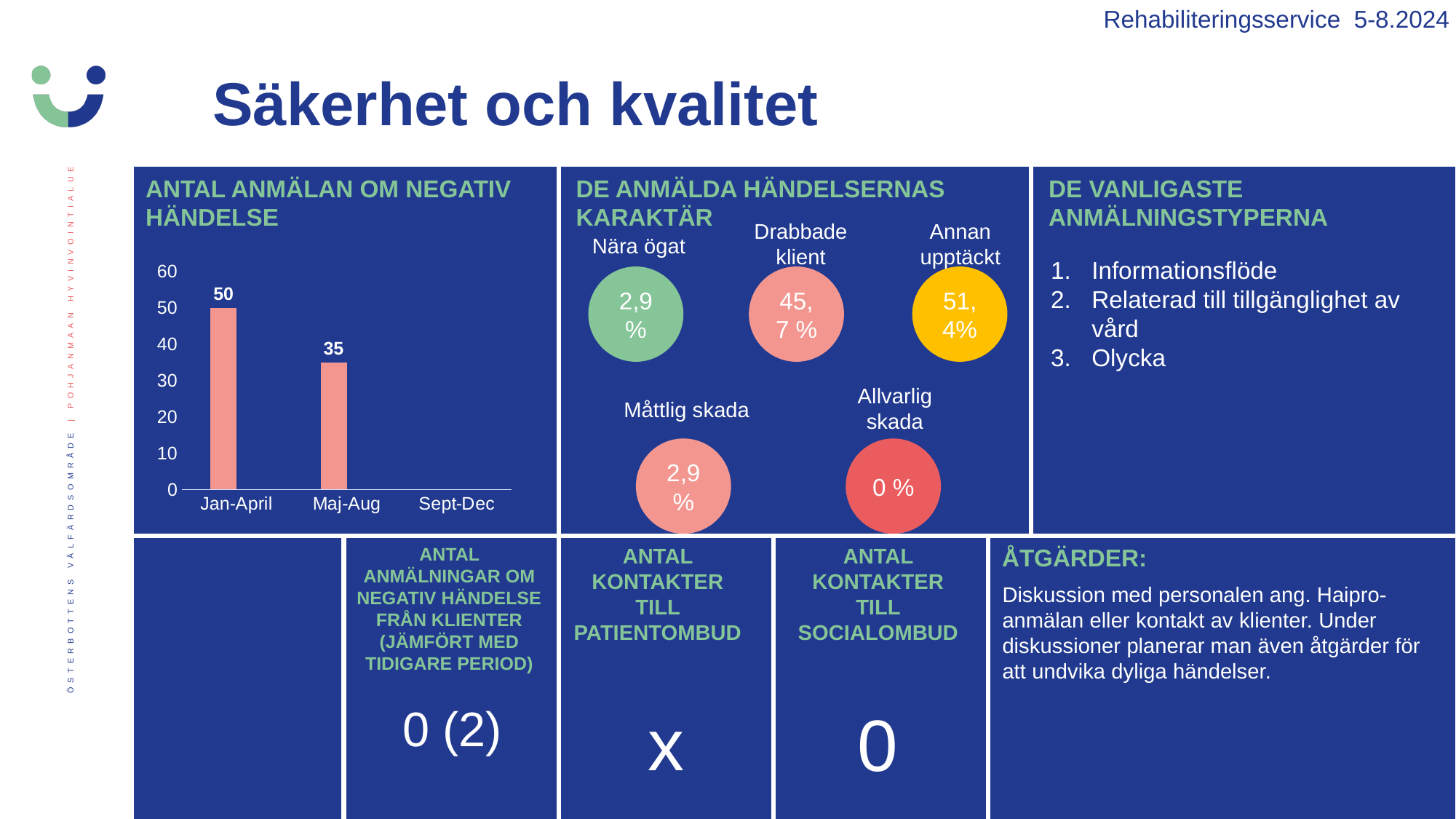
In the chart 'ANTAL ANMÄLAN OM NEGATIV HÄNDELSE', do the values rise or fall from Jan-April to Maj-Aug? fall In the chart 'ANTAL ANMÄLAN OM NEGATIV HÄNDELSE', is the value for Maj-Aug greater or less than 40? less In the chart 'ANTAL ANMÄLAN OM NEGATIV HÄNDELSE', what is the value for Maj-Aug? 35 What kind of chart is 'ANTAL ANMÄLAN OM NEGATIV HÄNDELSE'? bar chart What is the highest value shown on the y axis of the chart 'ANTAL ANMÄLAN OM NEGATIV HÄNDELSE'? 60 In the chart 'ANTAL ANMÄLAN OM NEGATIV HÄNDELSE', which is larger, Jan-April or Maj-Aug? Jan-April In the chart 'ANTAL ANMÄLAN OM NEGATIV HÄNDELSE', which period has no bar plotted? Sept-Dec In the chart 'ANTAL ANMÄLAN OM NEGATIV HÄNDELSE', what is the value for Jan-April? 50 In the chart 'ANTAL ANMÄLAN OM NEGATIV HÄNDELSE', what is the difference between Jan-April and Maj-Aug? 15 In the chart 'ANTAL ANMÄLAN OM NEGATIV HÄNDELSE', which period has the highest value? Jan-April In the chart 'ANTAL ANMÄLAN OM NEGATIV HÄNDELSE', what is the total of Jan-April and Maj-Aug? 85 How many categories are shown on the x axis of the chart 'ANTAL ANMÄLAN OM NEGATIV HÄNDELSE'? 3